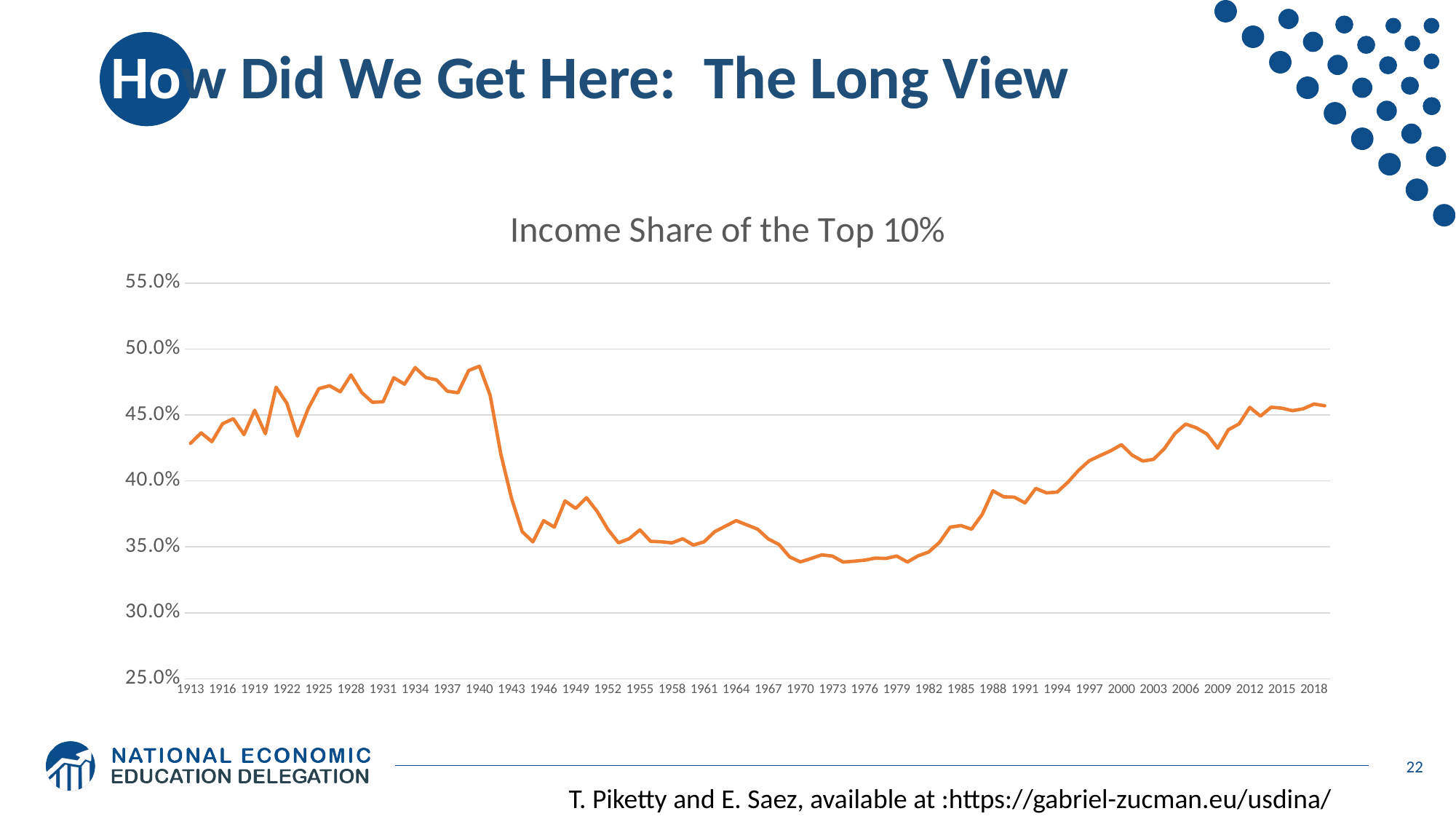
Is the value for 1970 greater or less than 35.0%? less Is the value for 1940 greater or less than 50.0%? less What colour is the line in the chart? orange What type of chart is shown on the slide? line chart Is the value for 2018 greater or less than 45.0%? greater Which year has the larger value, 1940 or 1970? 1940 Does the income share of the top 10% rise or fall between 1940 and 1946? fall Which year has the larger value, 1976 or 2018? 2018 What is the title of the chart? Income Share of the Top 10%